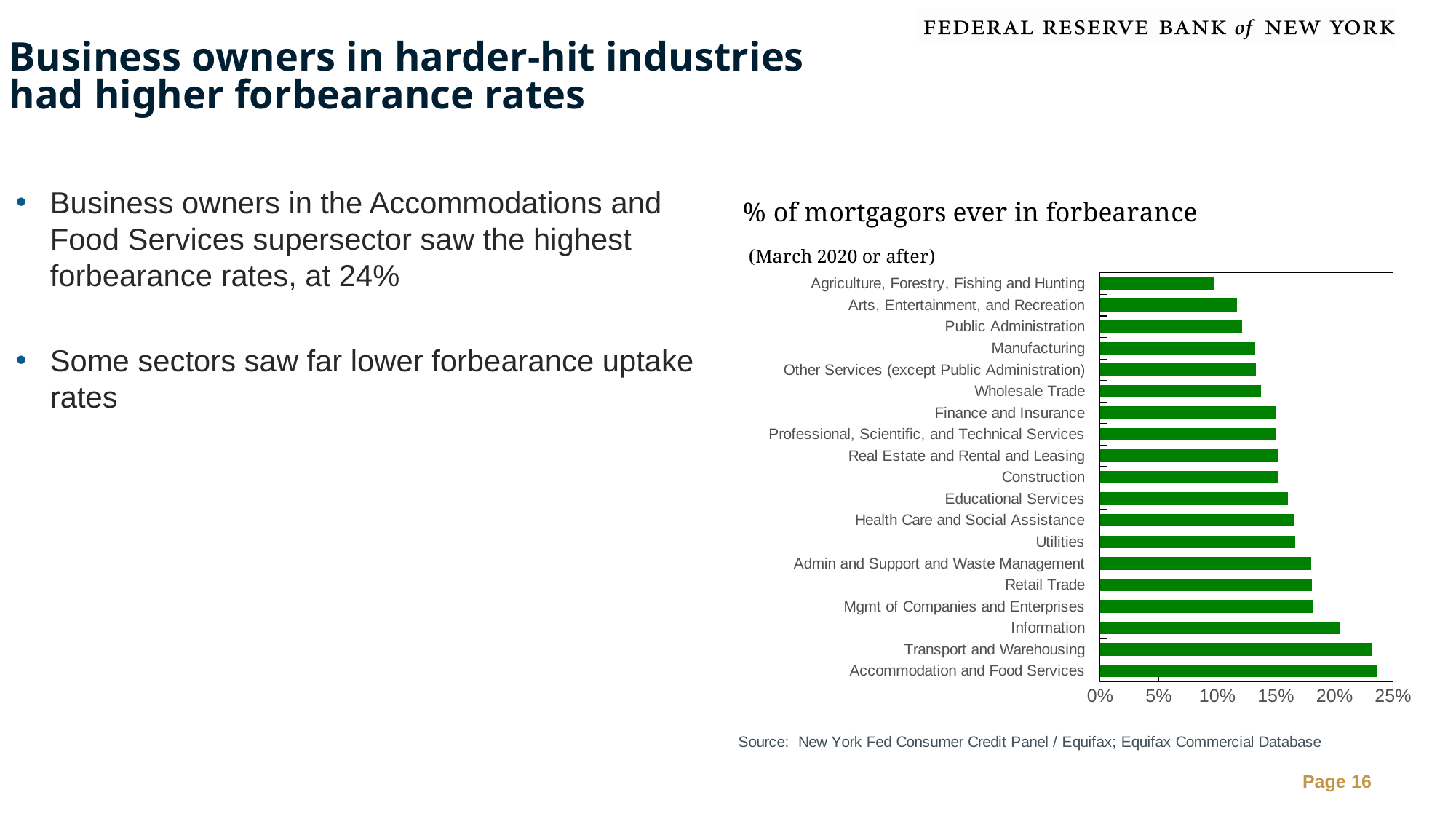
Is the value for Transport and Warehousing greater or less than 20%? greater Is the value for Retail Trade greater or less than 20%? less Which has a higher forbearance share, Retail Trade or Public Administration? Retail Trade What kind of chart is shown on the slide? Bar chart How many industry categories are plotted in the chart? 19 Which industry has the lowest share of mortgagors ever in forbearance? Agriculture, Forestry, Fishing and Hunting Which has a higher forbearance share, Information or Manufacturing? Information Is the value for Agriculture, Forestry, Fishing and Hunting greater or less than 15%? less What is the title of the chart? % of mortgagors ever in forbearance Which industry has the highest share of mortgagors ever in forbearance? Accommodation and Food Services